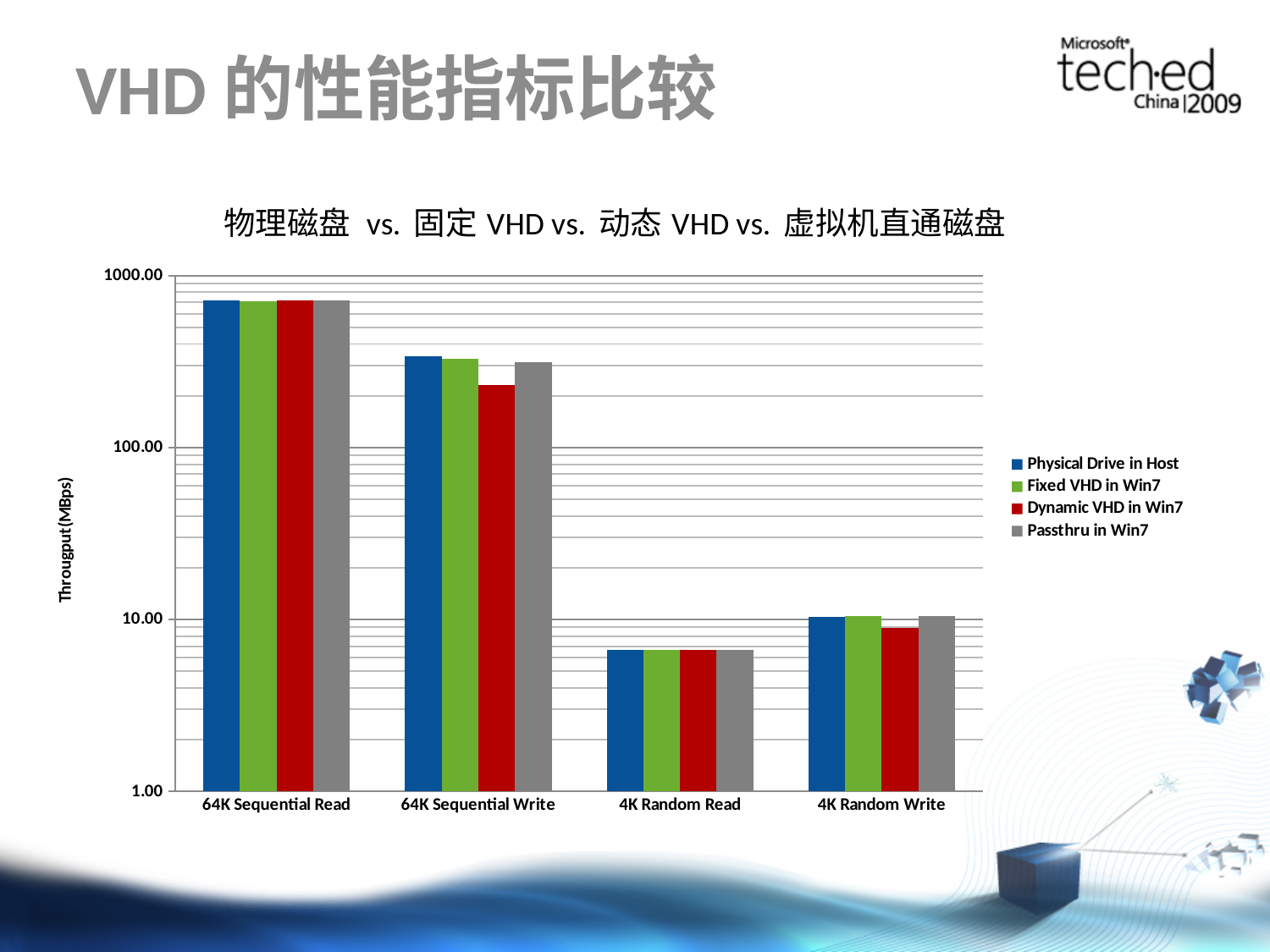
How many categories are shown on the x axis of the chart? 4 How many series does the chart's legend list? 4 At 64K Sequential Write, which is larger: Fixed VHD in Win7 or Dynamic VHD in Win7? Fixed VHD in Win7 Is the value for Physical Drive in Host at 64K Sequential Read greater or less than 100.00? greater Is the value for Dynamic VHD in Win7 at 4K Random Write greater or less than 10.00? less Is the value for Physical Drive in Host at 4K Random Read greater or less than 10.00? less For the Physical Drive in Host series, which category has the lowest throughput? 4K Random Read What is the label on the chart's y axis? Througput(MBps) Which colour represents Dynamic VHD in Win7 in the chart's legend? red What kind of chart is shown on the slide? bar chart For the Physical Drive in Host series, which category has the highest throughput? 64K Sequential Read